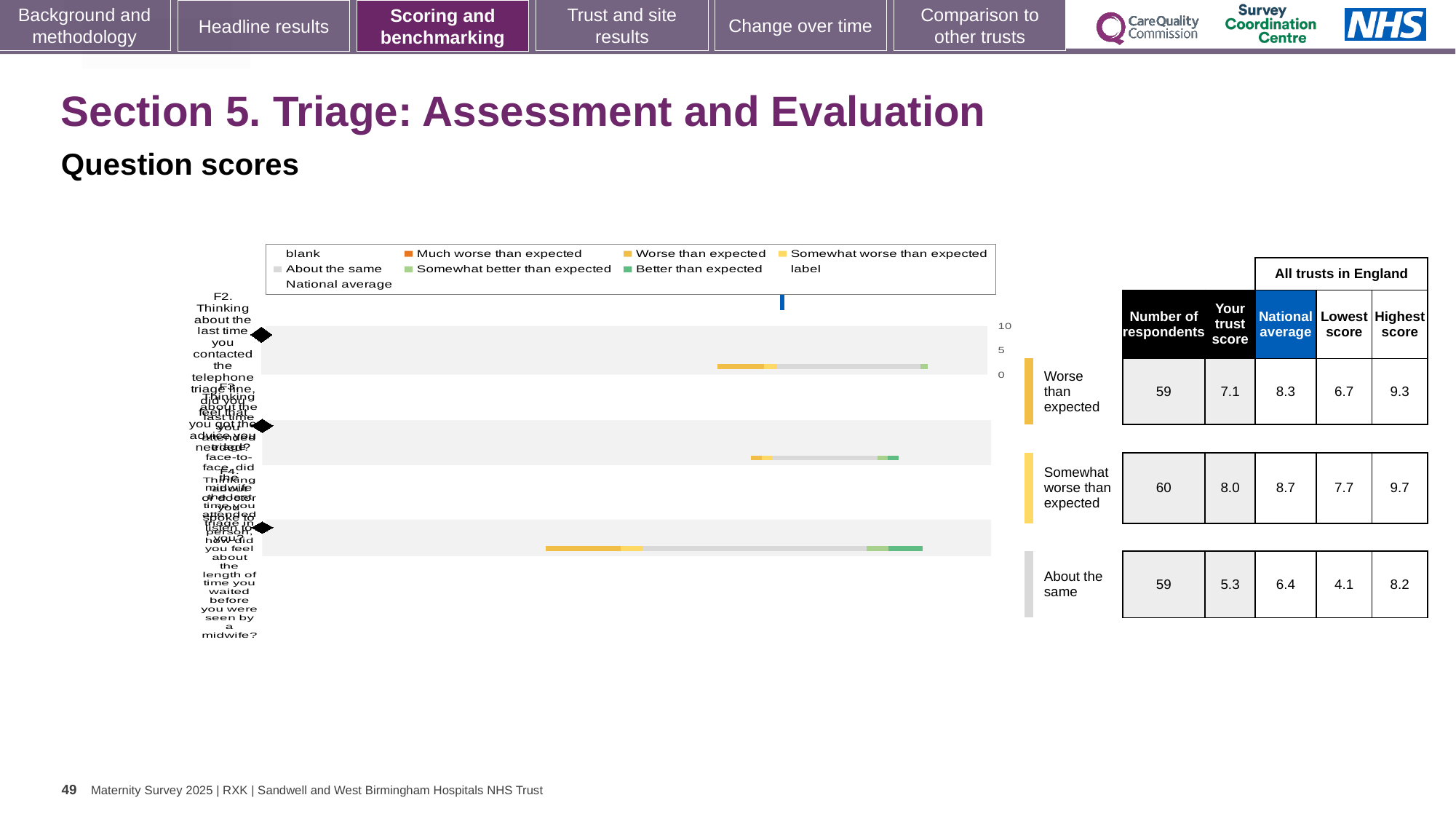
In the table, what is the national average for the row labelled 'Somewhat worse than expected'? 8.7 What kind of chart is shown on the slide? bar chart In the table, what is the number of respondents for the row labelled 'About the same'? 59 In the table, which row has the highest number of respondents? Somewhat worse than expected In the table, what is the difference between the national average and the trust score for the row labelled 'About the same'? 1.1 In the table, what is the lowest score for the row labelled 'About the same'? 4.1 In the table, which row has the lowest trust score? About the same In the table, for the row labelled 'Somewhat worse than expected', which is larger: the trust score or the national average? National average What colour does the legend use for 'Better than expected'? Green How many question rows are shown in the table? 3 In the table, what is the trust score for the row labelled 'Worse than expected'? 7.1 In the table, what is the highest score for the row labelled 'Somewhat worse than expected'? 9.7